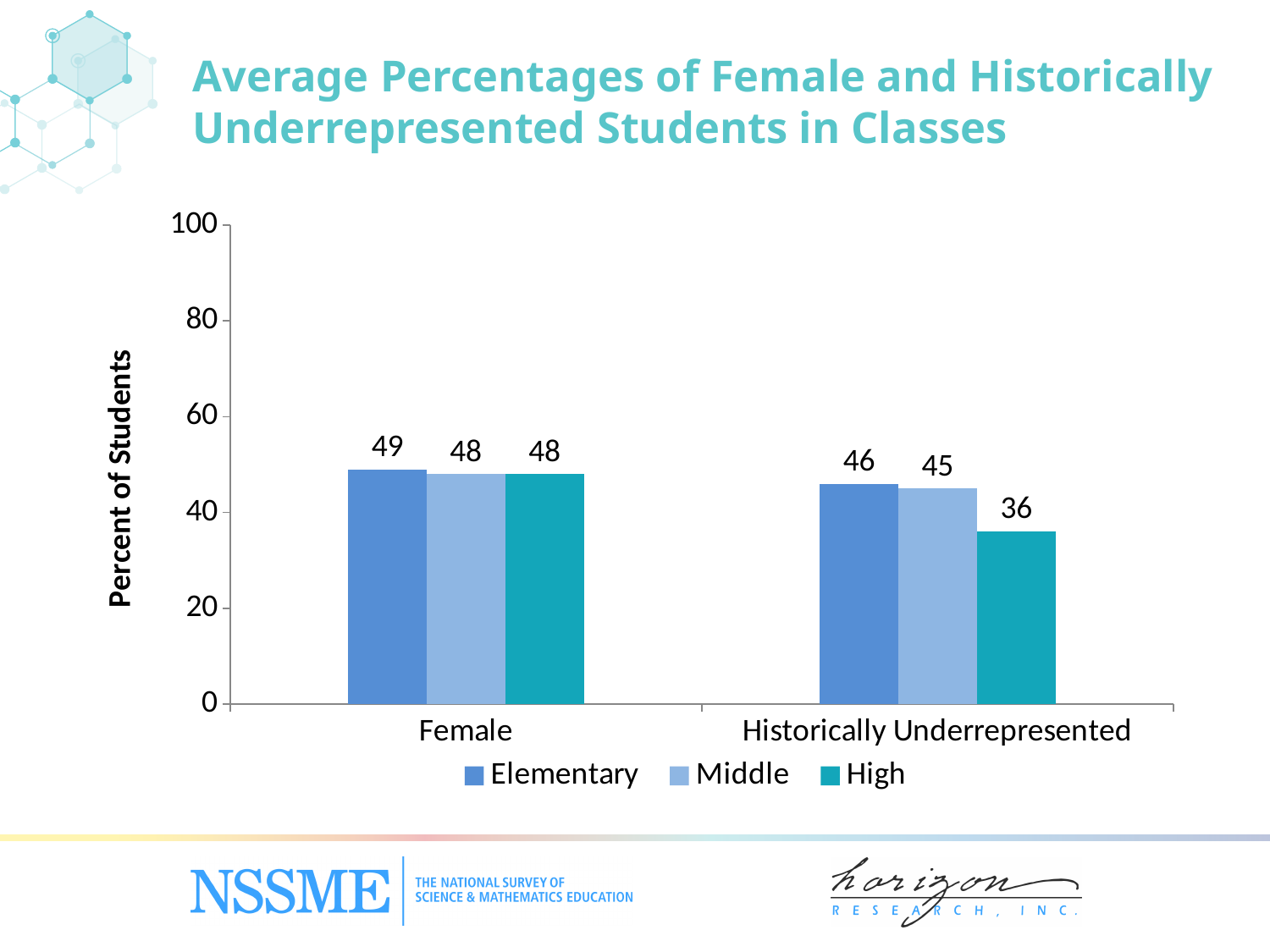
Which series has the lowest value in the Historically Underrepresented category? High Which series has the highest value in the Female category? Elementary What is the difference between the High value for Female and the High value for Historically Underrepresented? 12 Which is larger: the Middle value for Female or the Middle value for Historically Underrepresented? Female What is the value for High in the Historically Underrepresented category? 36 What is the value for Elementary in the Female category? 49 How many series does the legend list? 3 What kind of chart is shown on the slide? Bar chart Is the value for High in the Historically Underrepresented category greater or less than 40? less How many categories are shown on the x axis? 2 What is the difference between the Elementary and High values in the Historically Underrepresented category? 10 What is the value for Middle in the Historically Underrepresented category? 45